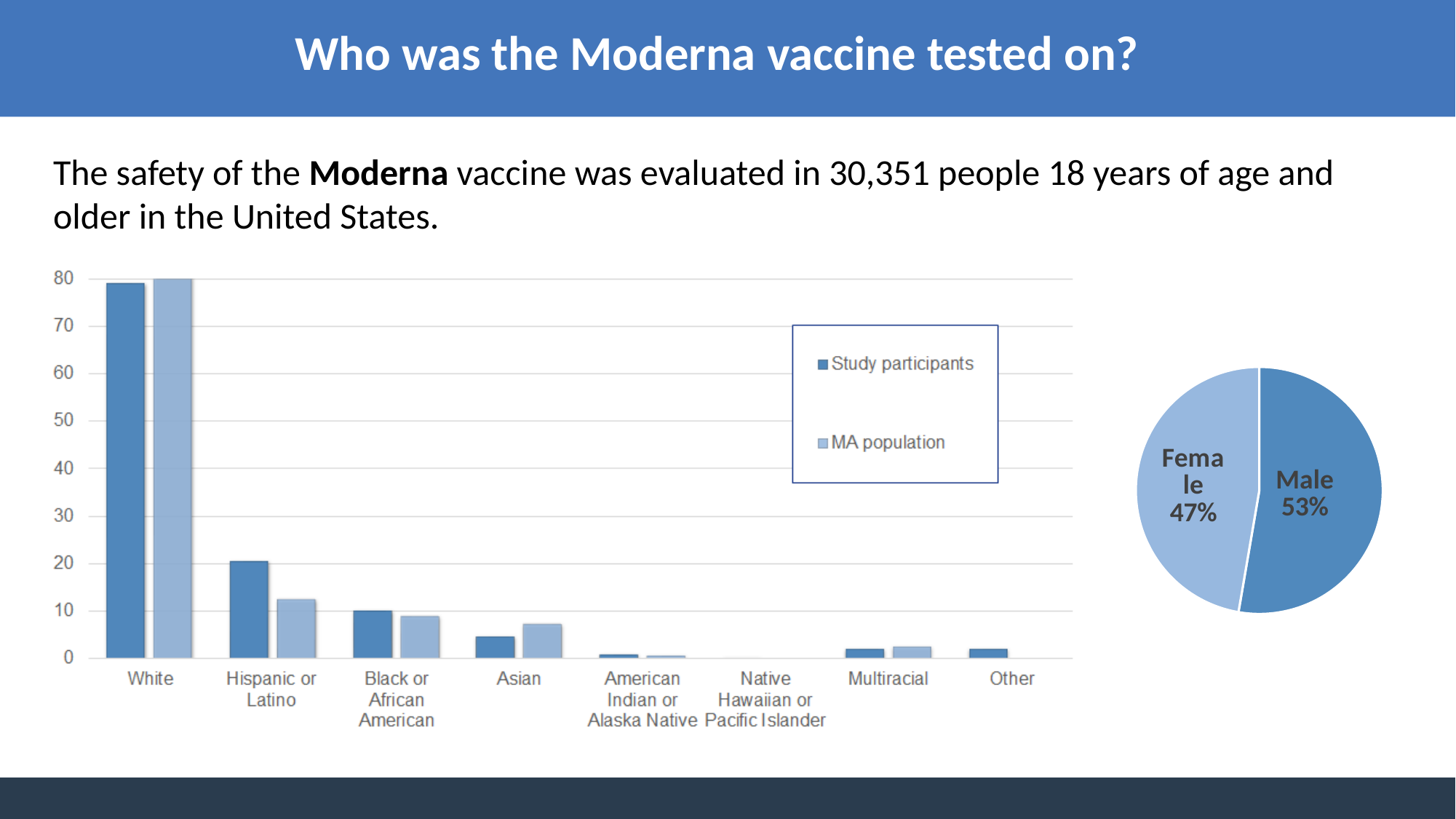
On the bar chart on the left, how many categories are shown on the x axis? 8 On the bar chart on the left, what are the two series named in the legend? Study participants and MA population What kind of chart is the chart on the left of the slide? Bar chart On the bar chart on the left, is the Study participants value for White greater or less than 70? greater On the bar chart on the left, how many series does the legend list? 2 On the pie chart, which slice is larger, Male or Female? Male On the bar chart on the left, is the MA population value for Asian greater or less than 10? less On the pie chart, what share is labelled Female? 47% On the pie chart, what is the difference between the Male and Female shares? 6% On the pie chart, what share is labelled Male? 53% On the bar chart on the left, which category has the highest value for Study participants? White On the bar chart on the left, for Hispanic or Latino, which is larger, Study participants or MA population? Study participants